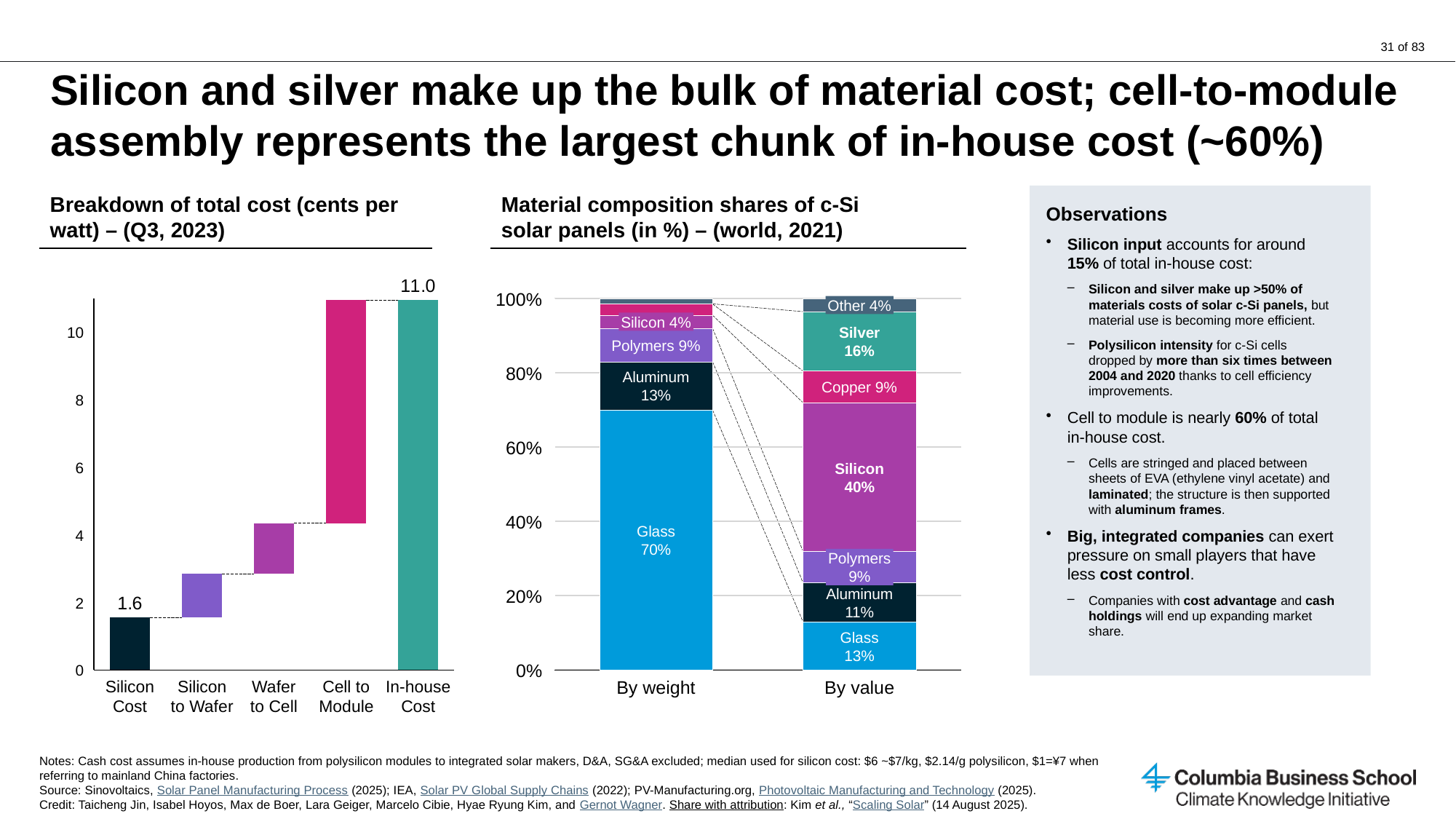
In the 'Material composition shares' chart, what is the share of Silicon by value? 40% In the 'Material composition shares' chart, what is the share of Silver by value? 16% In the 'Material composition shares' chart, is the Aluminum share larger by weight or by value? By weight In the 'Breakdown of total cost' chart, is the top of the Cell to Module bar greater or less than 10? greater In the 'Breakdown of total cost' chart, how many categories are shown on the x axis? 5 In the 'Breakdown of total cost' chart, what is the difference between the In-house Cost value and the Silicon Cost value? 9.4 In the 'Material composition shares' chart, which material has the largest share in the By value bar? Silicon What kind of chart is the 'Breakdown of total cost' chart? Bar chart (waterfall) In the 'Material composition shares' chart, what is the difference between the Glass share by weight and the Glass share by value? 57% In the 'Material composition shares' chart, what is the share of Glass by weight? 70% In the 'Breakdown of total cost' chart, what is the value shown for In-house Cost? 11.0 In the 'Breakdown of total cost' chart, what is the value shown for Silicon Cost? 1.6